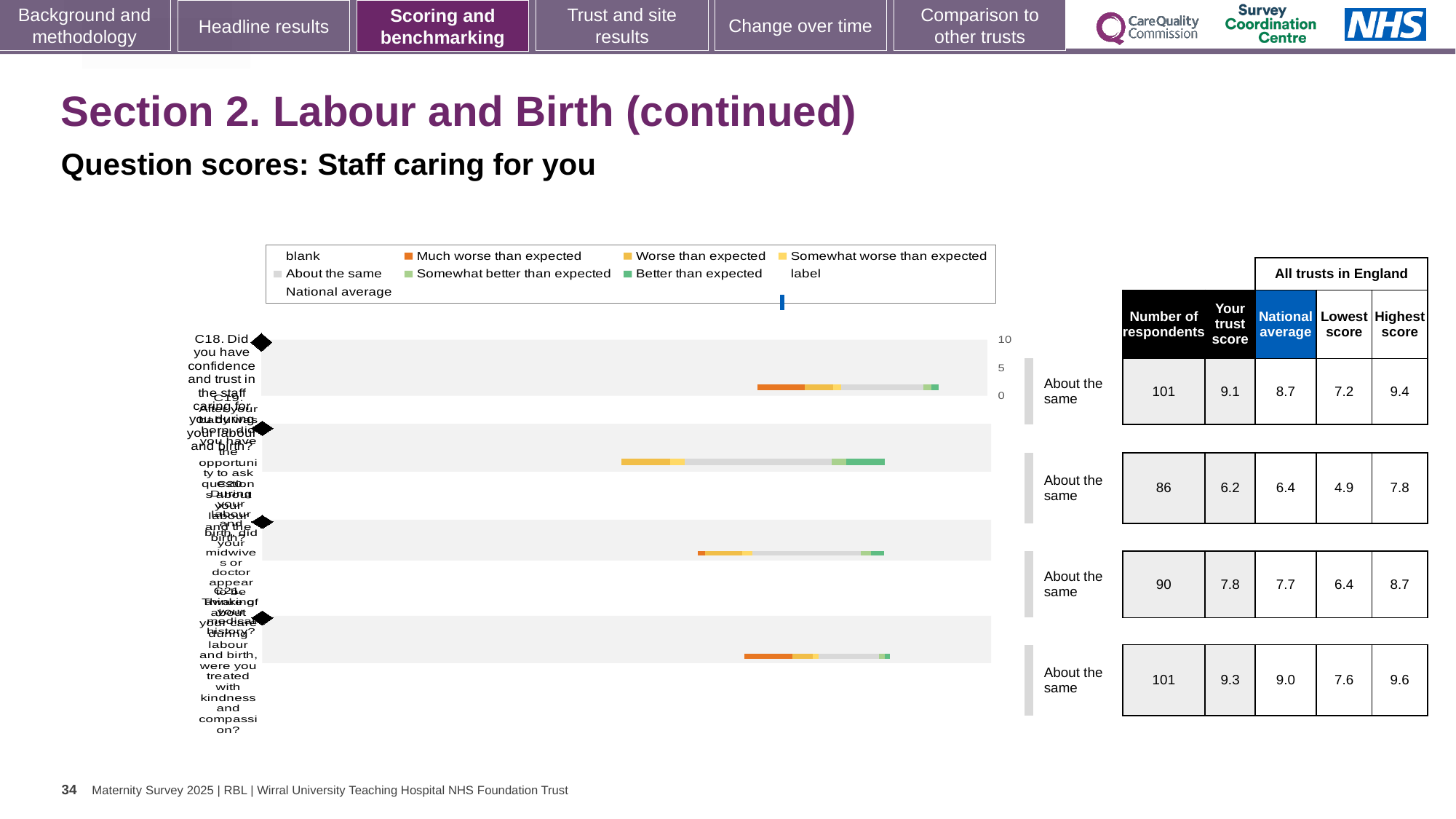
In the table, what is the Number of respondents for the third row? 90 What is the difference between 'Your trust score' and the National average in the first row? 0.4 What colour represents 'Much worse than expected' in the legend? orange What kind of chart is shown on the slide? bar chart Which row has the lowest 'Lowest score' in the table? the second row (4.9) How many question rows are plotted in the chart? 4 In the table, what is the 'Your trust score' for the first row (C18)? 9.1 In the table, what is the National average for the second row? 6.4 In the second row, which is larger: 'Your trust score' or the National average? National average Which row has the highest 'Your trust score' in the table? the fourth row (9.3) In the table, what is the Highest score for the fourth row? 9.6 What benchmark category is shown for every question row? About the same